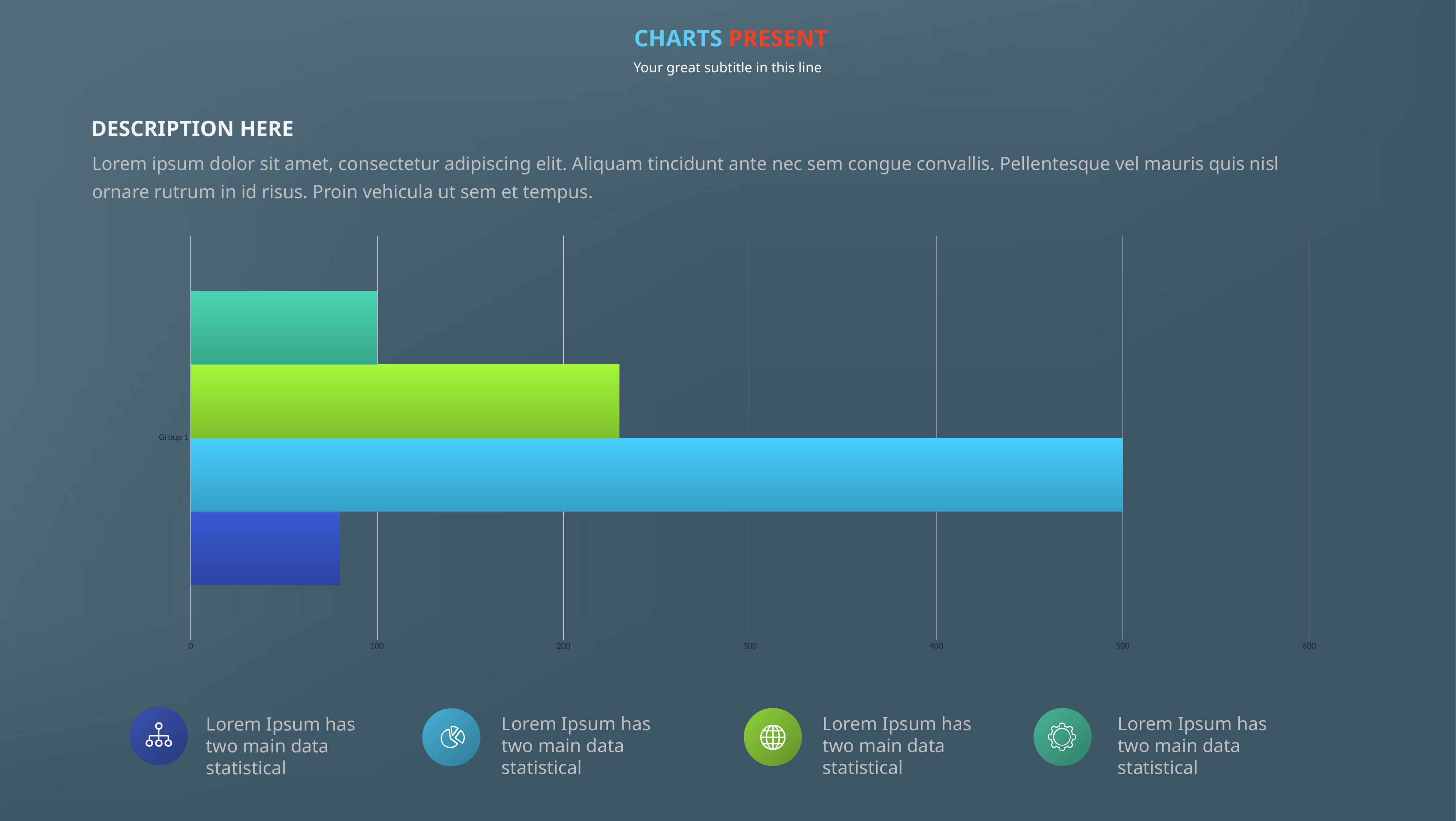
Which coloured bar is the shortest in the chart? the dark blue bar Is the value of the dark blue (bottom) bar greater or less than 100? less What value does the teal (top) bar reach on the horizontal axis? 100 What value does the light blue bar reach on the horizontal axis? 500 What is the label of the category shown on the chart's vertical axis? Group 1 How many categories are shown on the vertical axis of the chart? 1 Which coloured bar is the longest in the chart? the light blue bar Is the value of the green bar greater or less than 300? less What is the highest value shown on the chart's horizontal axis? 600 Which is larger, the green bar or the teal bar? the green bar Is the value of the green bar greater or less than 200? greater What kind of chart is shown on the slide? bar chart